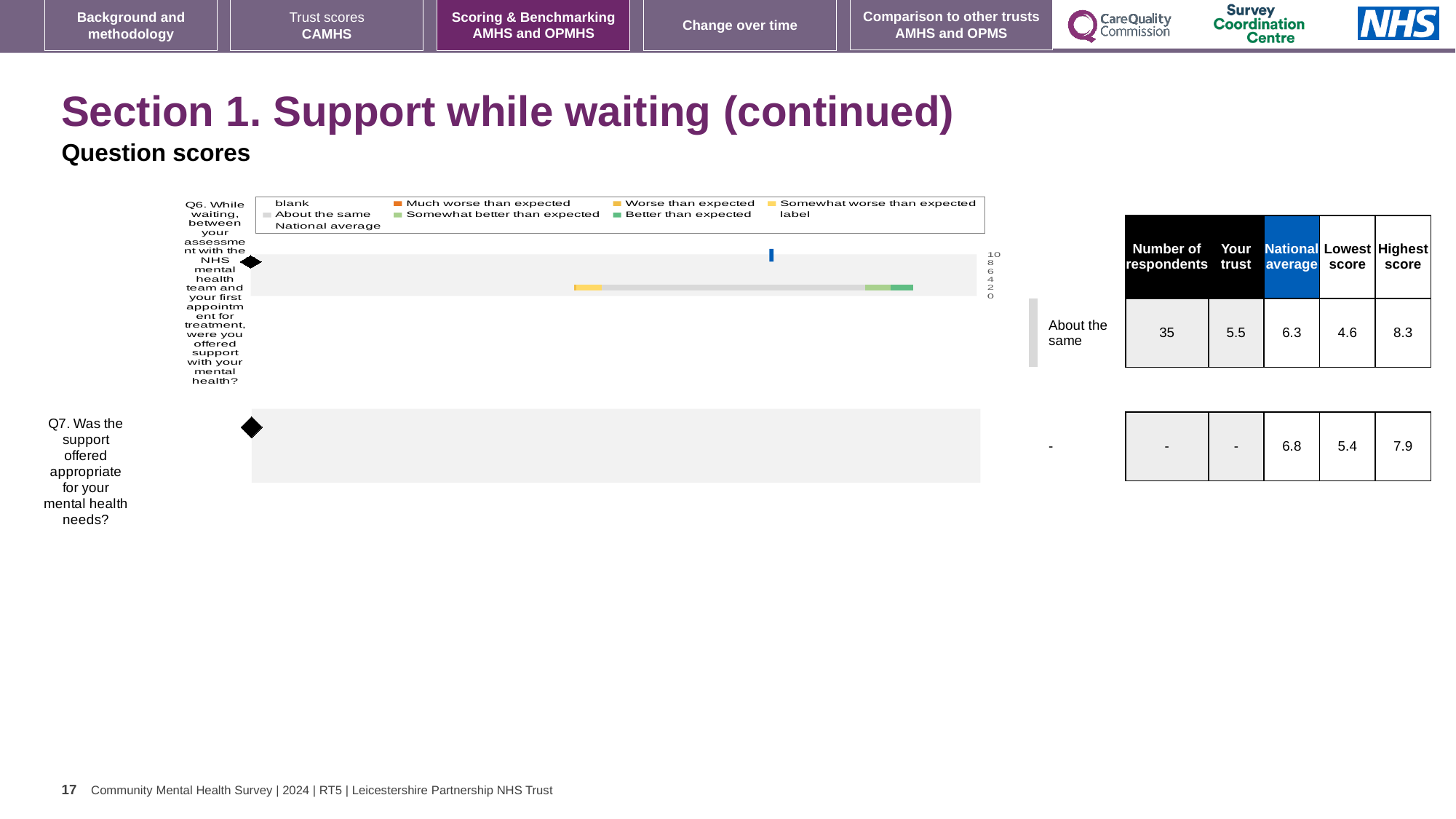
What colour does the legend use for 'Better than expected'? green What is the number of respondents for Q6? 35 How many questions are plotted on the chart? 2 What is the difference between the highest score and the lowest score for Q6? 3.7 How many entries does the chart legend list? 9 What is the national average score for Q6? 6.3 What is the 'Your trust' score for Q6? 5.5 What is the national average score for Q7? 6.8 What is the highest score for Q6? 8.3 What kind of chart is used to show the Q6 question score? bar chart For Q6, which is larger: the 'Your trust' score or the national average? National average What colour does the legend use for 'Much worse than expected'? orange